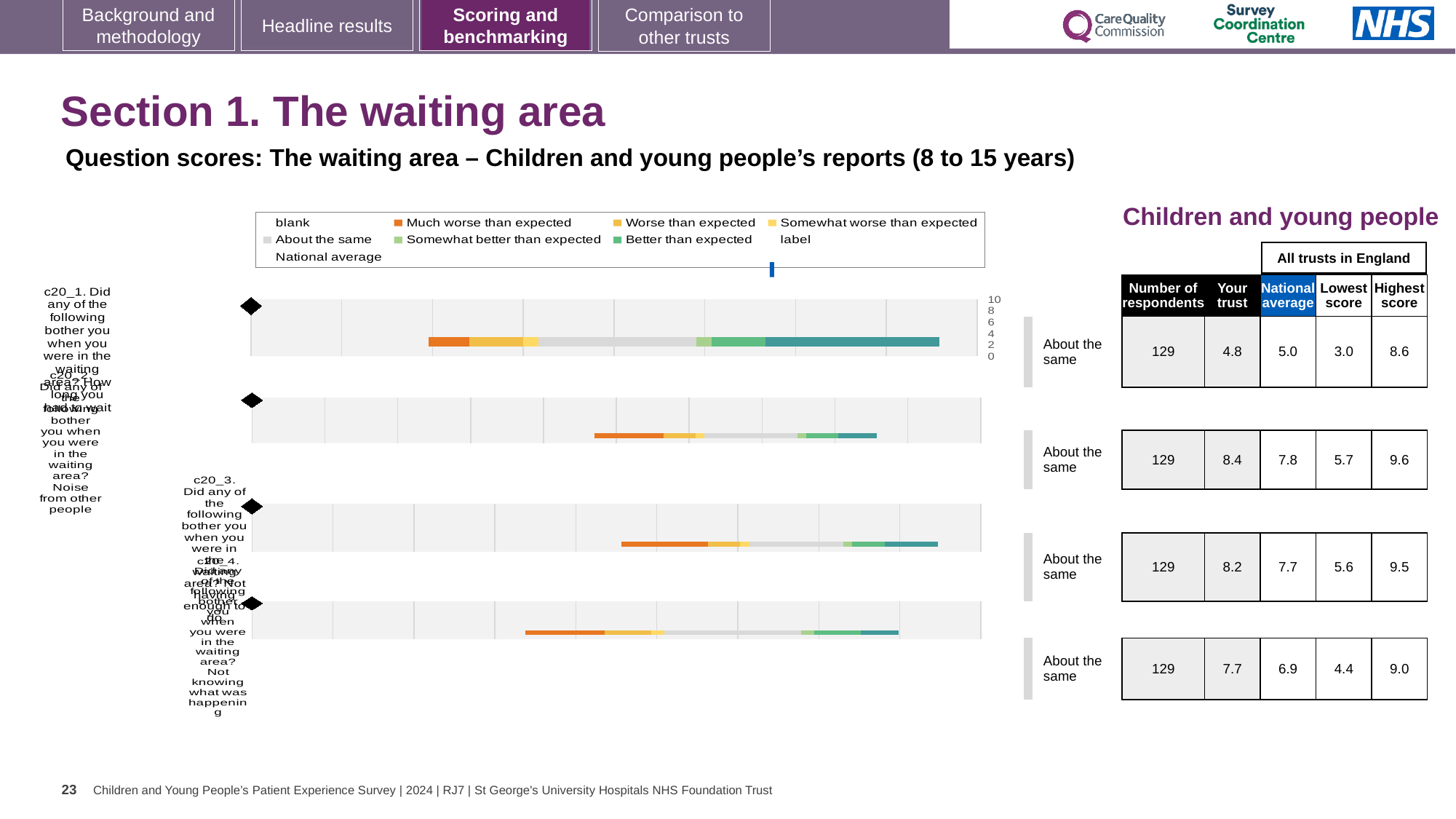
What is the 'Your trust' score for the first question row (c20_1) in the table beside the chart? 4.8 Which question row has the highest 'Your trust' score in the table beside the chart? the second row (8.4) Which question row has the lowest 'Your trust' score in the table beside the chart? the first row, c20_1 (4.8) What benchmark category label is shown next to every bar in the chart? About the same For the first question row, which is larger: the 'Your trust' score or the national average? National average What is the national average for the second question row in the table beside the chart? 7.8 In the chart legend, which colour represents 'Much worse than expected'? orange For the first question row, what is the difference between the highest score (8.6) and the lowest score (3.0)? 5.6 How many respondents are listed for each question row in the table beside the chart? 129 What kind of chart is used to show the question scores for the waiting area? bar chart According to the legend, what does the blue marker in the chart represent? National average How many question rows (bars) are plotted in the waiting area chart? 4